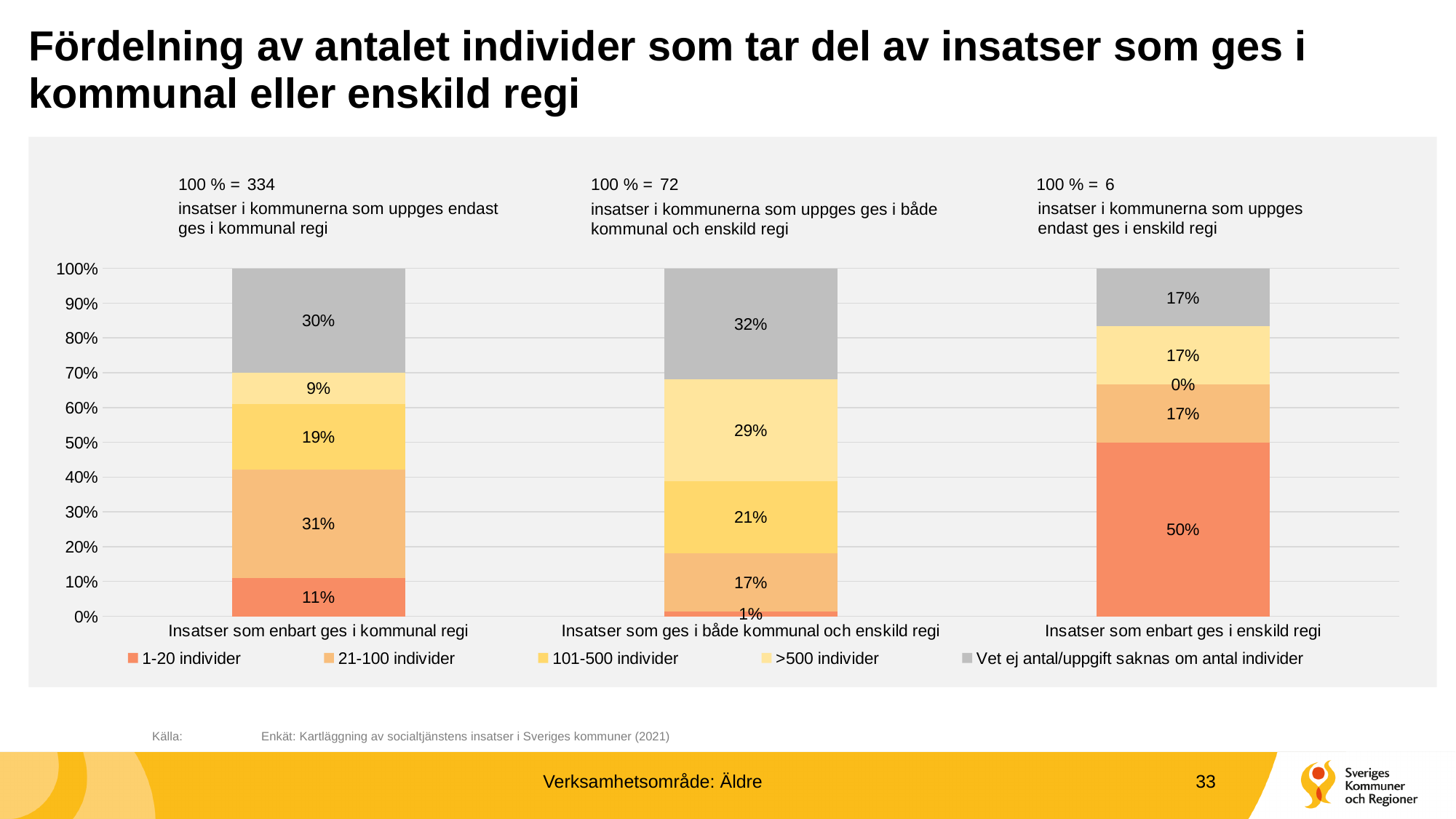
How many series does the legend list? 5 What is the value for '1-20 individer' in the category 'Insatser som enbart ges i enskild regi'? 50% What is the value for '>500 individer' in the category 'Insatser som ges i både kommunal och enskild regi'? 29% What is the difference between the '21-100 individer' values for 'Insatser som enbart ges i kommunal regi' and 'Insatser som ges i både kommunal och enskild regi'? 14% Which category has the lowest value for 'Vet ej antal/uppgift saknas om antal individer'? Insatser som enbart ges i enskild regi How many categories are shown on the x axis? 3 What is the value for '1-20 individer' in the category 'Insatser som enbart ges i kommunal regi'? 11% What is the value for 'Vet ej antal/uppgift saknas om antal individer' in the category 'Insatser som ges i både kommunal och enskild regi'? 32% Which is larger: the '101-500 individer' value for 'Insatser som enbart ges i kommunal regi' or for 'Insatser som ges i både kommunal och enskild regi'? Insatser som ges i både kommunal och enskild regi What kind of chart is shown on the slide? stacked bar chart According to the text above the chart, how many insatser does 100 % correspond to for the category 'Insatser som enbart ges i kommunal regi'? 334 Which category has the highest value for '1-20 individer'? Insatser som enbart ges i enskild regi